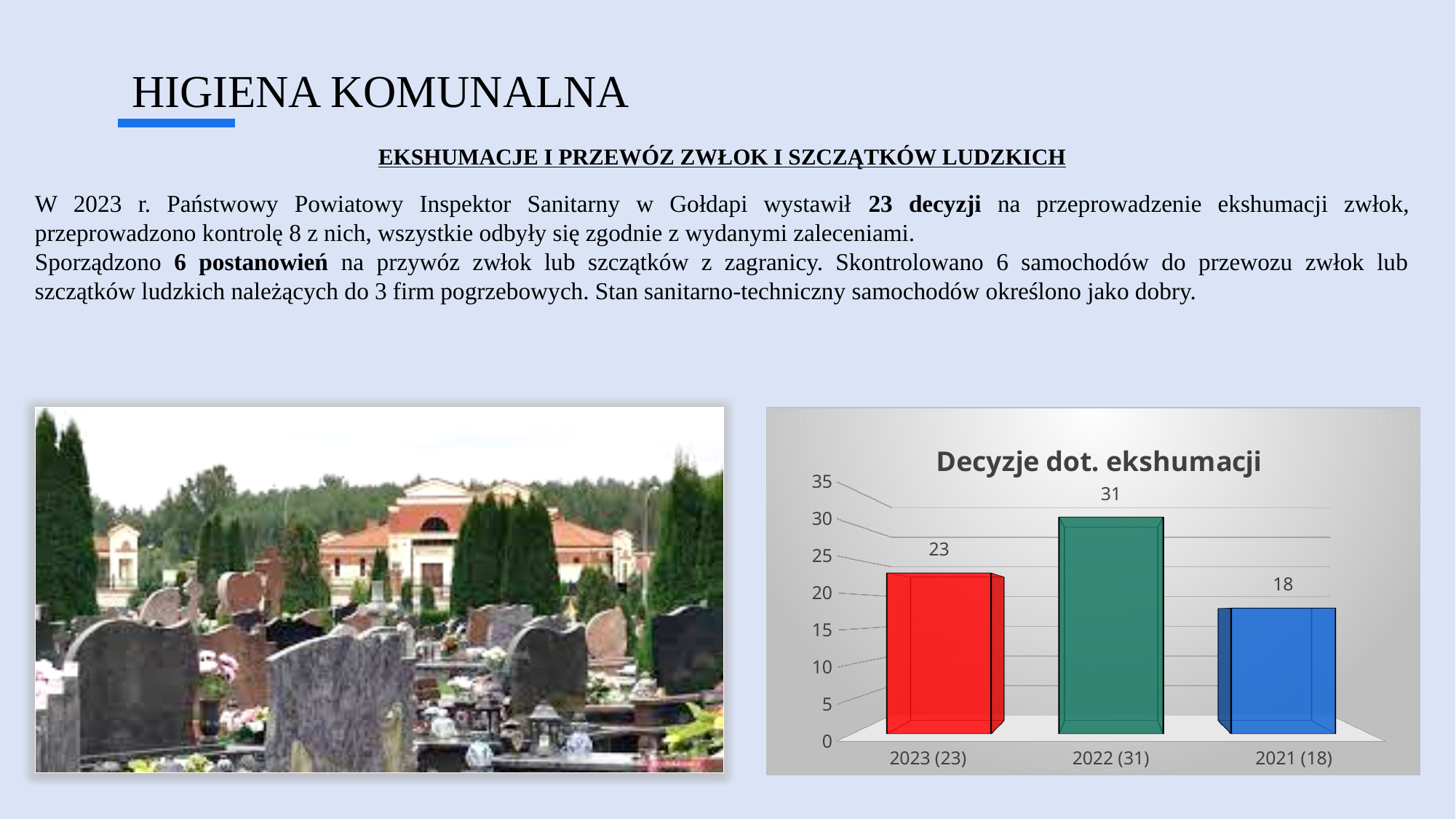
What kind of chart is shown on the slide? bar chart What is the title of the chart? Decyzje dot. ekshumacji What is the difference between the values for 2022 (31) and 2021 (18)? 13 Is the value for 2022 (31) greater or less than 25? greater What is the difference between the values for 2022 (31) and 2023 (23)? 8 What is the value for 2021 (18) in the chart? 18 Which category has the lowest value in the chart? 2021 (18) How many categories are shown in the chart? 3 Which is larger, the value for 2023 (23) or the value for 2021 (18)? 2023 (23) Which category has the highest value in the chart? 2022 (31) What is the value for 2022 (31) in the chart? 31 What is the value for 2023 (23) in the chart? 23